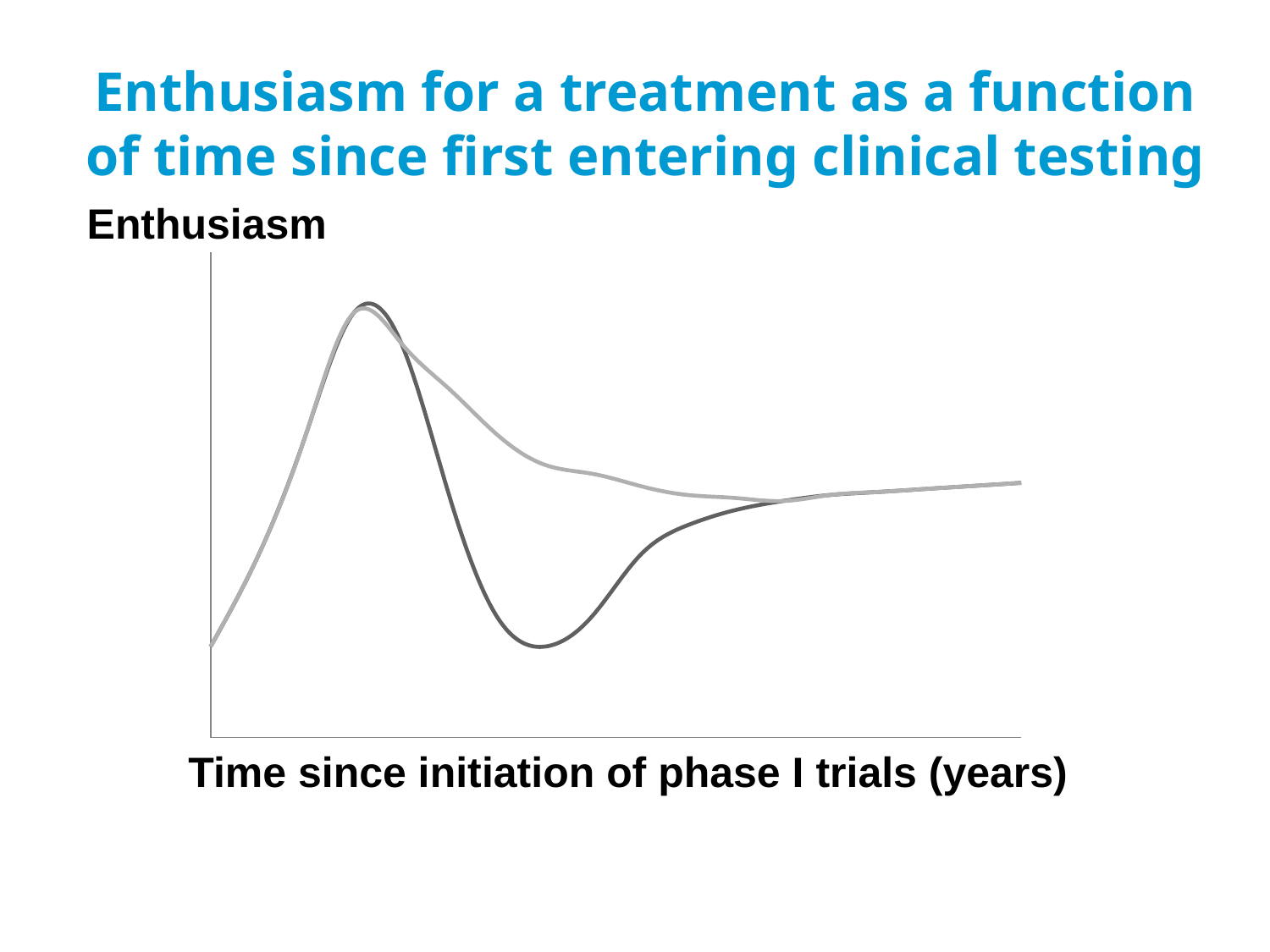
Does the light gray line ever dip below its starting value after its peak? No Which line dips lower after the peak, the dark gray line or the light gray line? The dark gray line Does the light gray line rise or fall at the start of the x axis, before its peak? Rise What kind of chart is shown on the slide? Line chart What is the title of the chart on the slide? Enthusiasm for a treatment as a function of time since first entering clinical testing Does the dark gray line rise or fall immediately after its peak? Fall How many lines are plotted on the chart? 2 What is the label of the horizontal axis of the chart? Time since initiation of phase I trials (years)